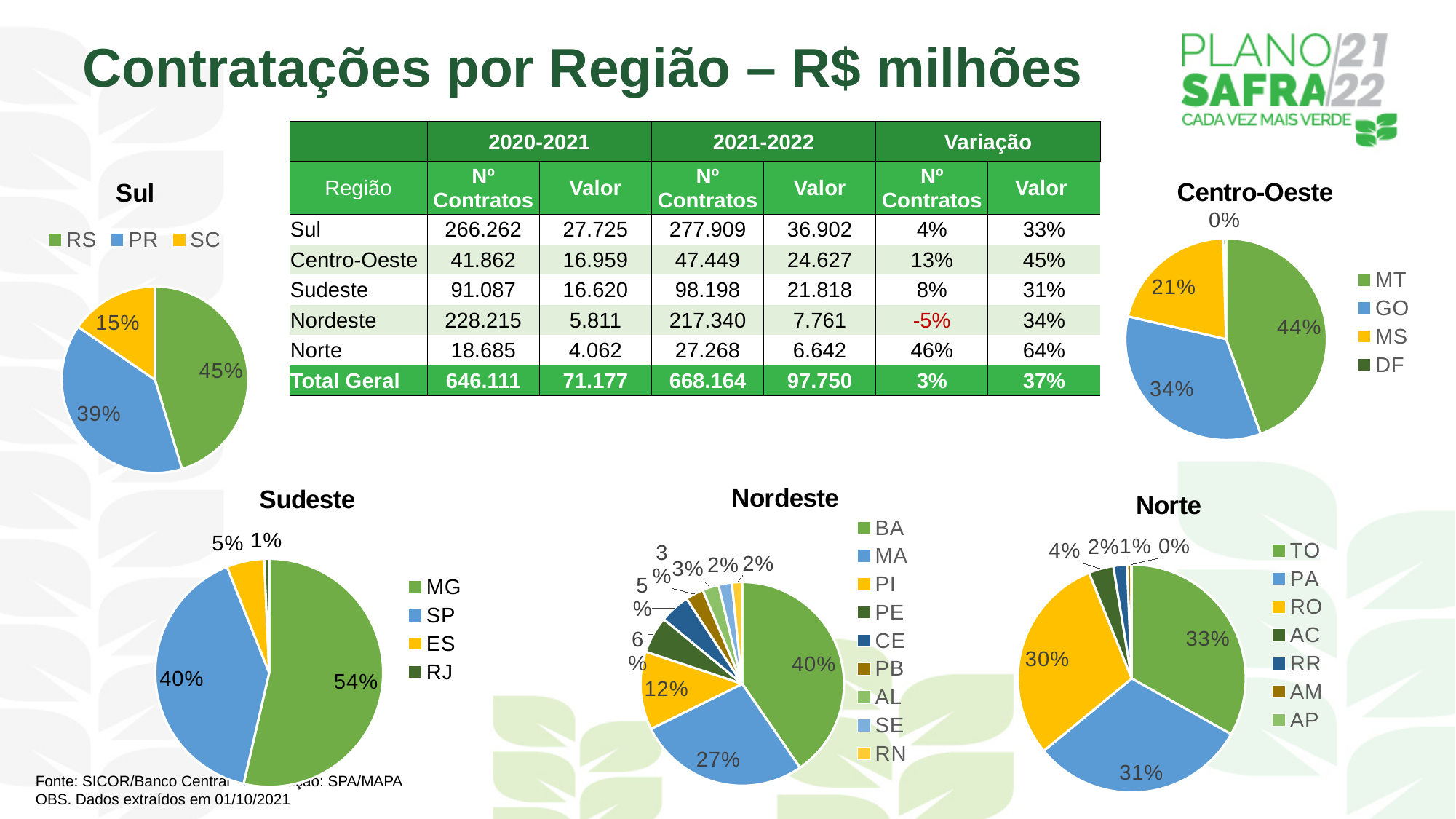
How many states does the legend of the Nordeste pie chart list? 9 In the Nordeste pie chart, what share does MA have? 27% In the Norte pie chart, what share does AC have? 4% In the Centro-Oeste pie chart, which state has the largest share? MT In the Sul pie chart, what share does RS have? 45% What type of chart is used for the Norte region? Pie chart In the Centro-Oeste pie chart, what is the difference between the MT and MS shares? 23% In the Norte pie chart, which is larger, the share for PA or the share for RO? PA In the Sudeste pie chart, what share does SP have? 40% In the Sul pie chart, which state has the smallest share? SC In the Centro-Oeste pie chart, what share does GO have? 34% How many states does the legend of the Sudeste pie chart list? 4